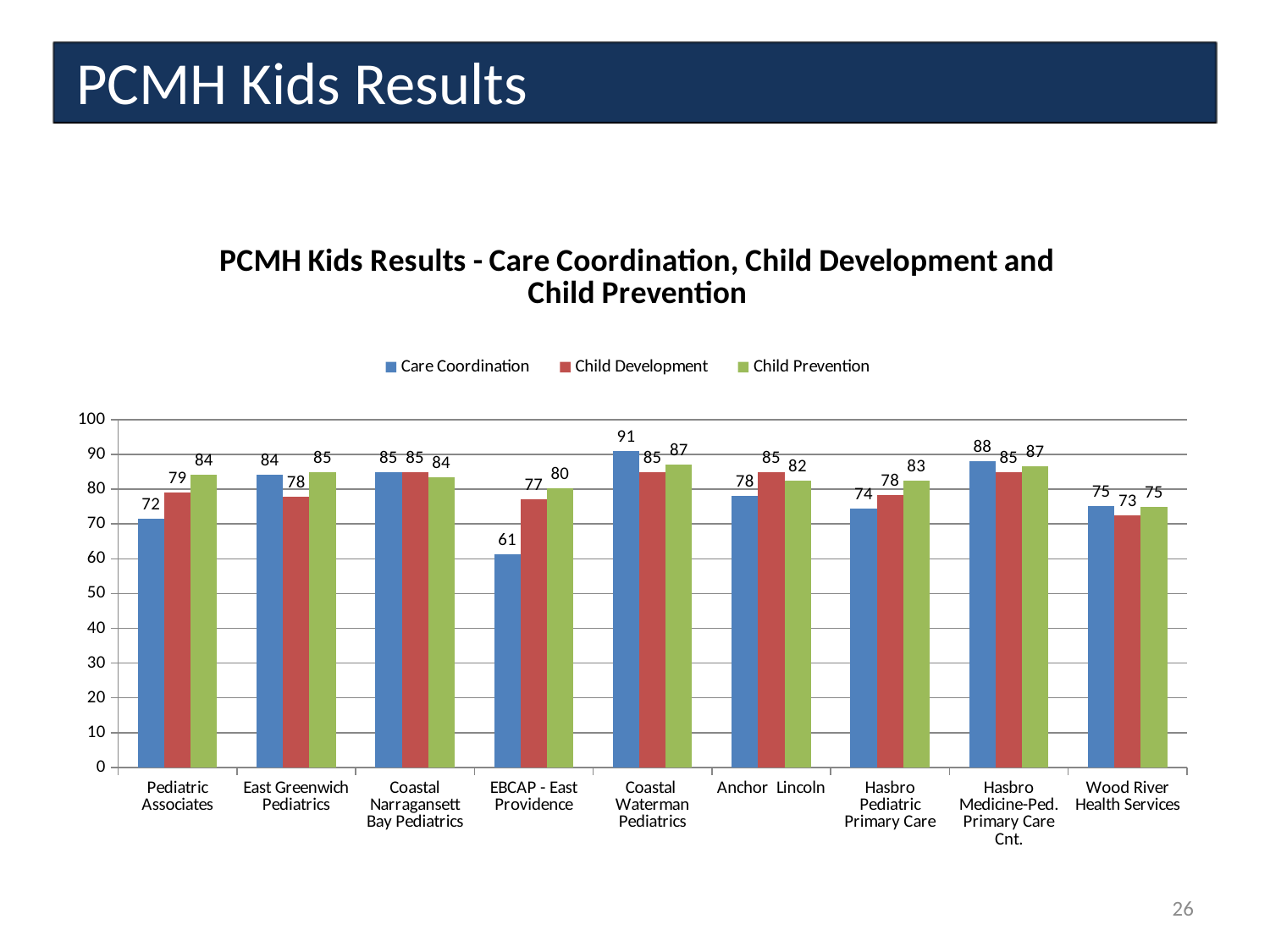
Which practice has the lowest Care Coordination value? EBCAP - East Providence What kind of chart is shown on the slide? bar chart What is the Child Prevention value for Hasbro Pediatric Primary Care? 83 How many series does the legend list? 3 Which practice has the lowest Child Development value? Wood River Health Services Which practice has the highest Care Coordination value? Coastal Waterman Pediatrics What is the Care Coordination value for EBCAP - East Providence? 61 For Pediatric Associates, which is larger: Care Coordination or Child Prevention? Child Prevention What is the Child Development value for Wood River Health Services? 73 What is the difference between the Care Coordination and Child Development values for Coastal Waterman Pediatrics? 6 Is the Care Coordination value for EBCAP - East Providence greater or less than 70? less How many practices are shown on the x axis? 9